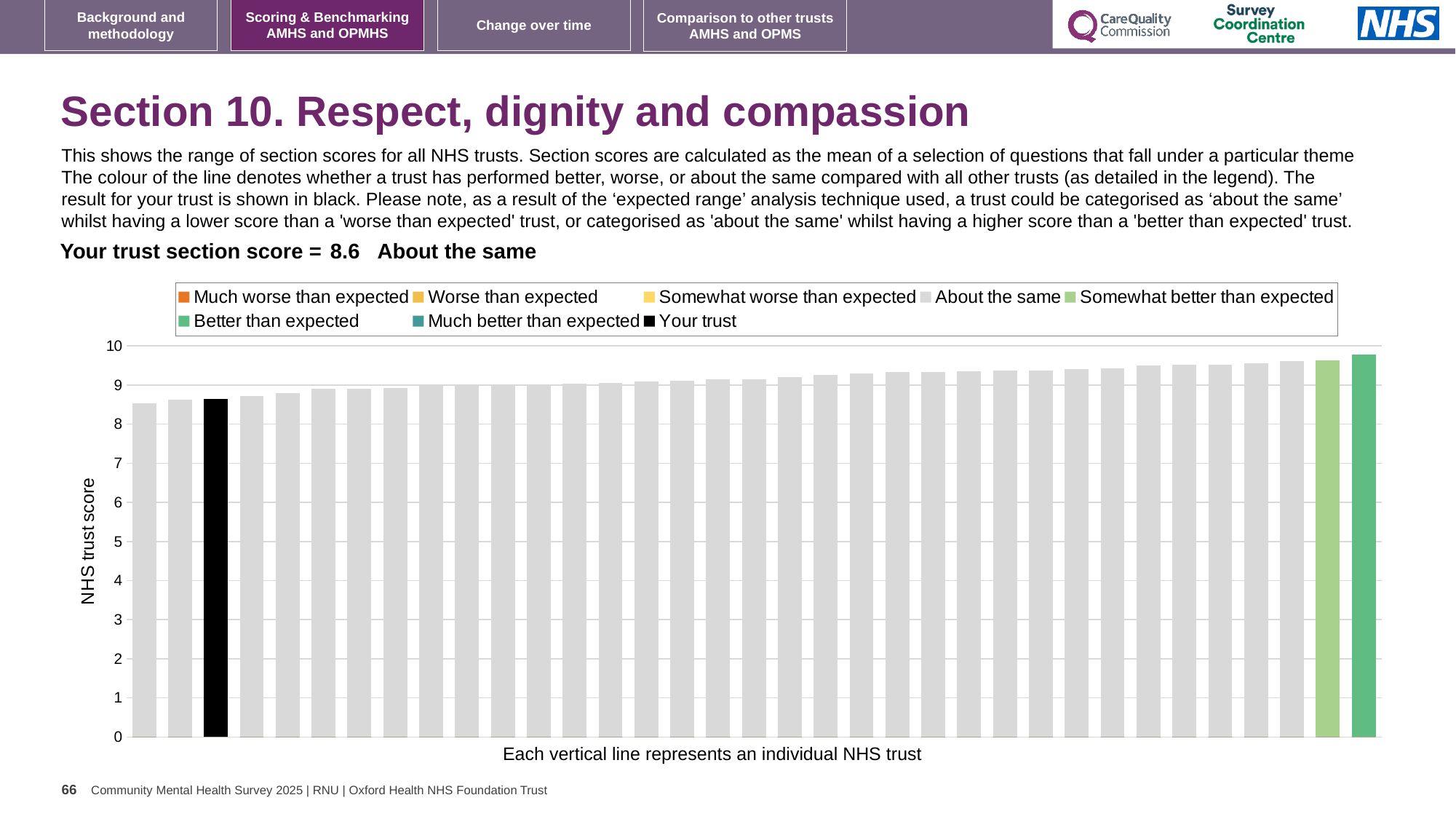
How is your trust categorised for this section score? About the same How many categories does the legend list? 8 Is the value of the leftmost (shortest) bar greater or less than 8? greater How many bars are coloured dark green (Better than expected)? 1 Is the value of the tallest bar greater or less than 9? greater How many bars are coloured light green (Somewhat better than expected)? 1 What is your trust's section score for Section 10, Respect, dignity and compassion? 8.6 Is the value of the black bar for your trust greater or less than 9? less What colour is the bar representing your trust? black Do the bar values rise or fall from left to right along the x axis? rise What kind of chart is shown on the slide? bar chart